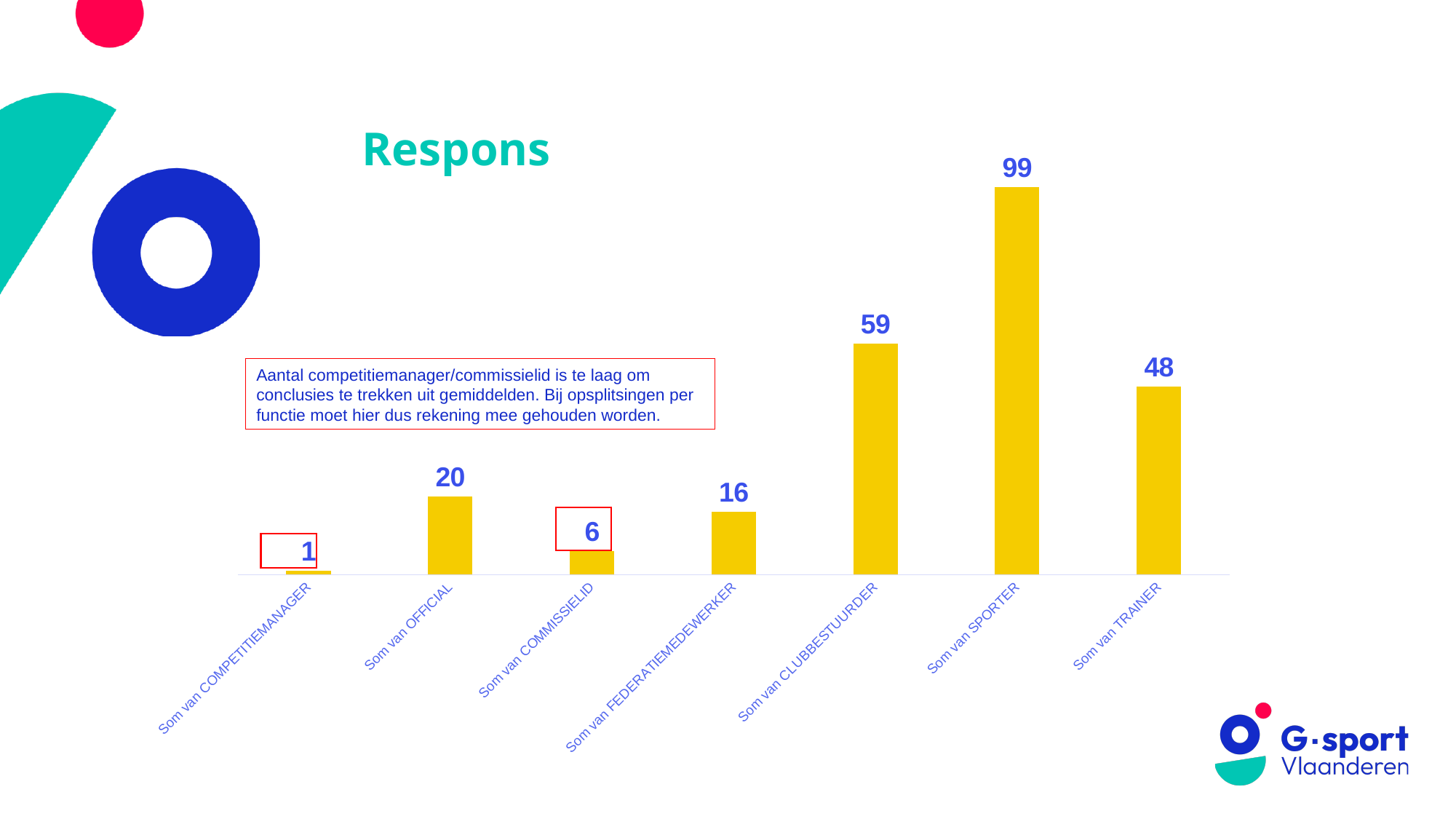
What is the value for Som van SPORTER? 99 What is the value for Som van OFFICIAL? 20 What kind of chart is shown on the slide? Bar chart What is the value for Som van FEDERATIEMEDEWERKER? 16 Which category has the lowest value? Som van COMPETITIEMANAGER Which is larger, the value for Som van CLUBBESTUURDER or the value for Som van TRAINER? Som van CLUBBESTUURDER What is the difference between the values for Som van SPORTER and Som van CLUBBESTUURDER? 40 What is the difference between the values for Som van TRAINER and Som van OFFICIAL? 28 What is the title of the slide containing the chart? Respons What is the value for Som van COMMISSIELID? 6 Which category has the highest value? Som van SPORTER How many categories are shown in the chart? 7